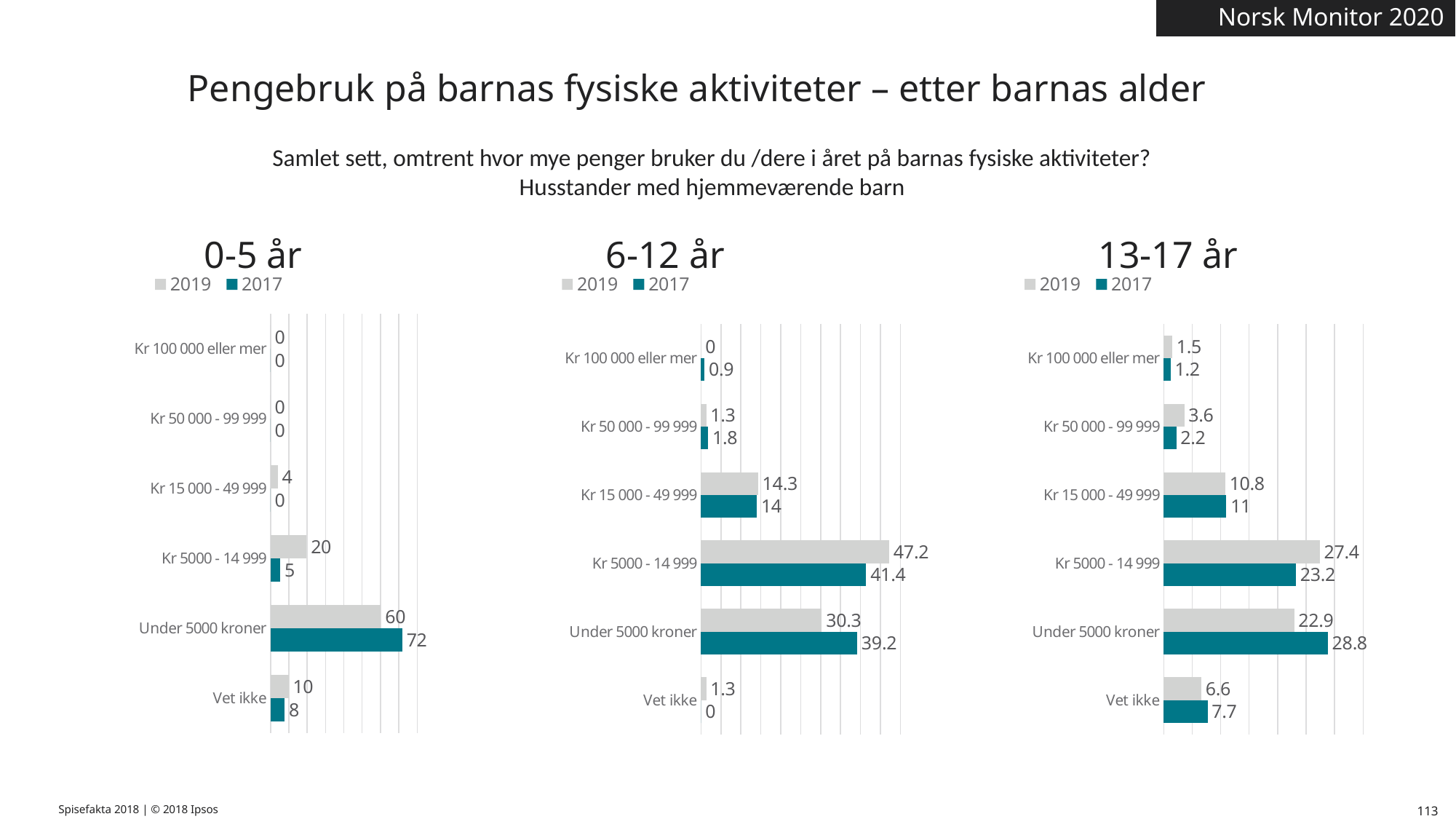
In the 6-12 år chart, what is the difference between the 2019 and 2017 values for Kr 5000 - 14 999? 5.8 In the 13-17 år chart, what is the 2017 value for Vet ikke? 7.7 How many categories are shown in the 0-5 år chart? 6 In the 6-12 år chart, what is the 2019 value for Kr 5000 - 14 999? 47.2 How many series does the legend of the 13-17 år chart list? 2 In the 6-12 år chart, which is larger for Under 5000 kroner: the 2019 value or the 2017 value? 2017 In the 0-5 år chart, what is the 2017 value for Under 5000 kroner? 72 In the 13-17 år chart, which category has the highest 2017 value? Under 5000 kroner In the 0-5 år chart, what is the difference between the 2017 and 2019 values for Under 5000 kroner? 12 What type of chart is the 6-12 år chart? Bar chart In the 6-12 år chart, which category has the highest 2019 value? Kr 5000 - 14 999 In the 13-17 år chart, which is larger for Kr 50 000 - 99 999: the 2019 value or the 2017 value? 2019